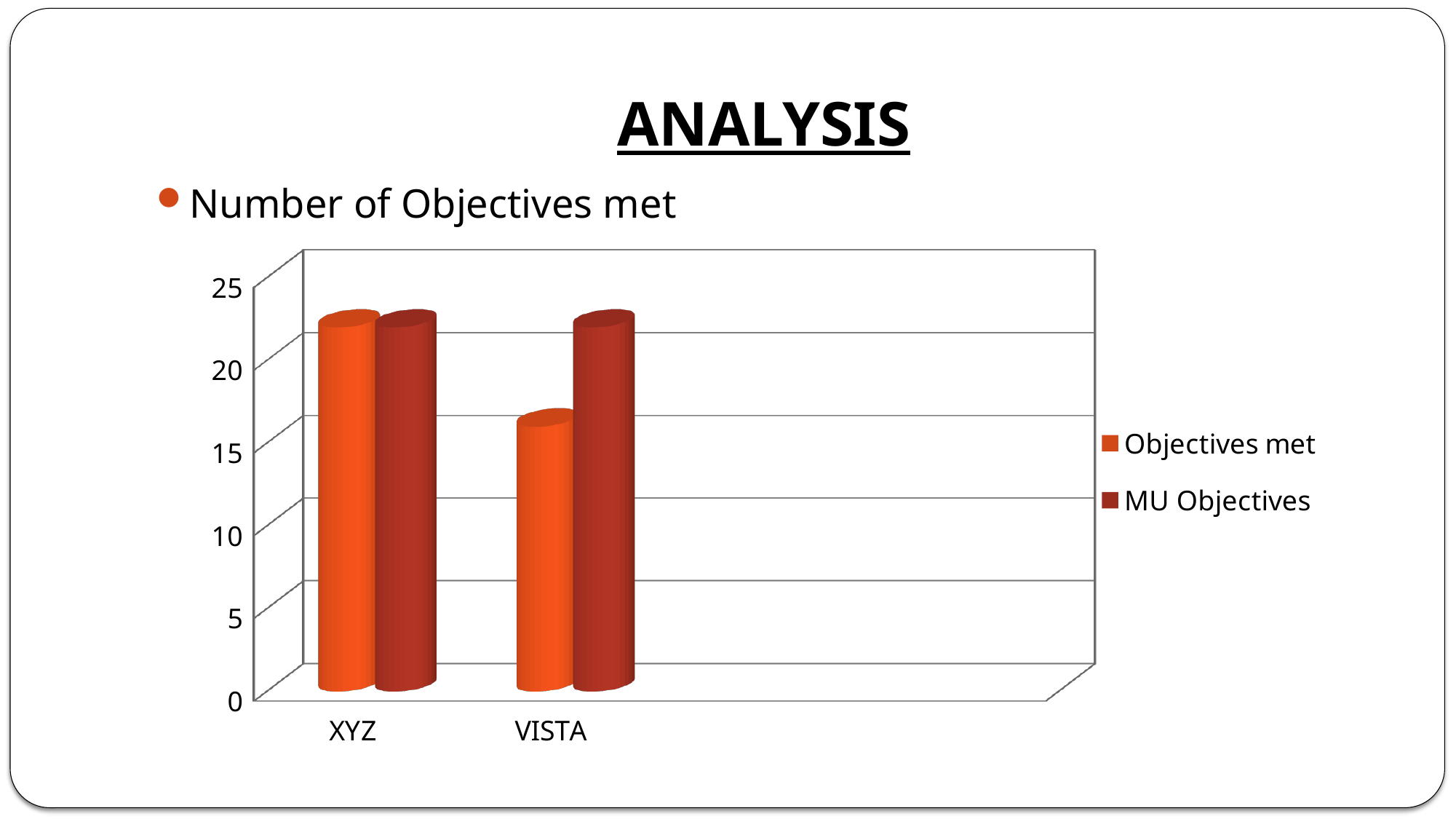
Which category has the lowest value for Objectives met? VISTA For the Objectives met series, which category is larger: XYZ or VISTA? XYZ What are the two series named in the chart's legend? Objectives met, MU Objectives Does the Objectives met series rise or fall from XYZ to VISTA? fall Is the value for Objectives met for VISTA greater or less than 20? less For VISTA, which is larger: Objectives met or MU Objectives? MU Objectives Is the value for Objectives met for VISTA greater or less than 10? greater What is the heading text above the chart? Number of Objectives met How many series does the chart's legend list? 2 How many categories are shown on the x axis of the chart? 2 What kind of chart is shown on the slide? bar chart Is the value for MU Objectives for VISTA greater or less than 20? greater